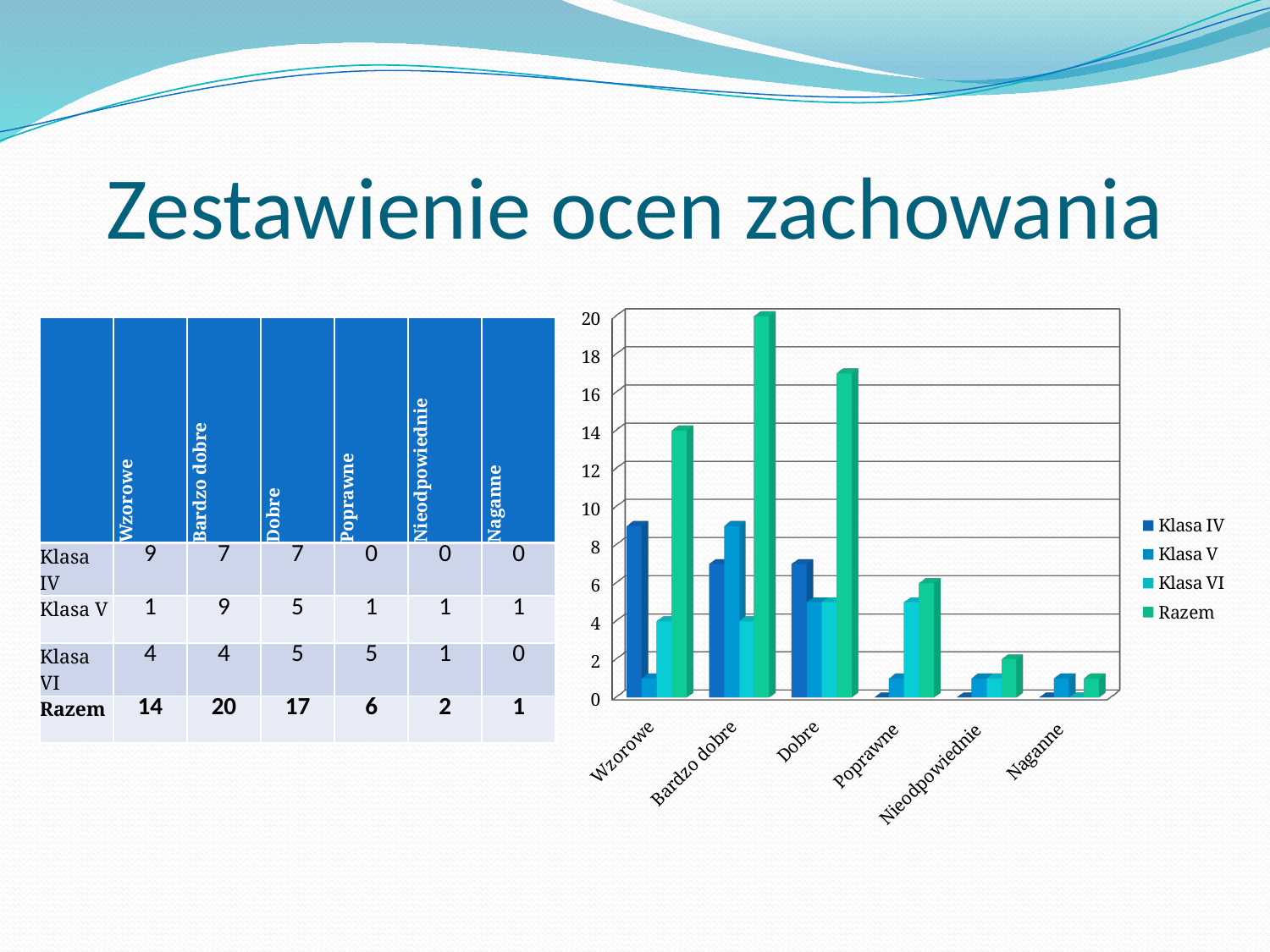
How many series does the chart legend list? 4 Is the Razem value for Dobre greater or less than 14? greater What is the Klasa VI value for Poprawne? 5 What is the difference between the Razem value for Bardzo dobre and the Razem value for Wzorowe? 6 What are the entries listed in the chart legend? Klasa IV, Klasa V, Klasa VI, Razem How many categories are shown along the x axis of the chart? 6 Which category has the highest value for the Razem series? Bardzo dobre For Wzorowe, which is larger: the Klasa IV value or the Klasa V value? Klasa IV What is the Razem value for Wzorowe? 14 What is the Razem value for Bardzo dobre? 20 Which category has the lowest value for the Razem series? Naganne What kind of chart is shown on the slide? bar chart